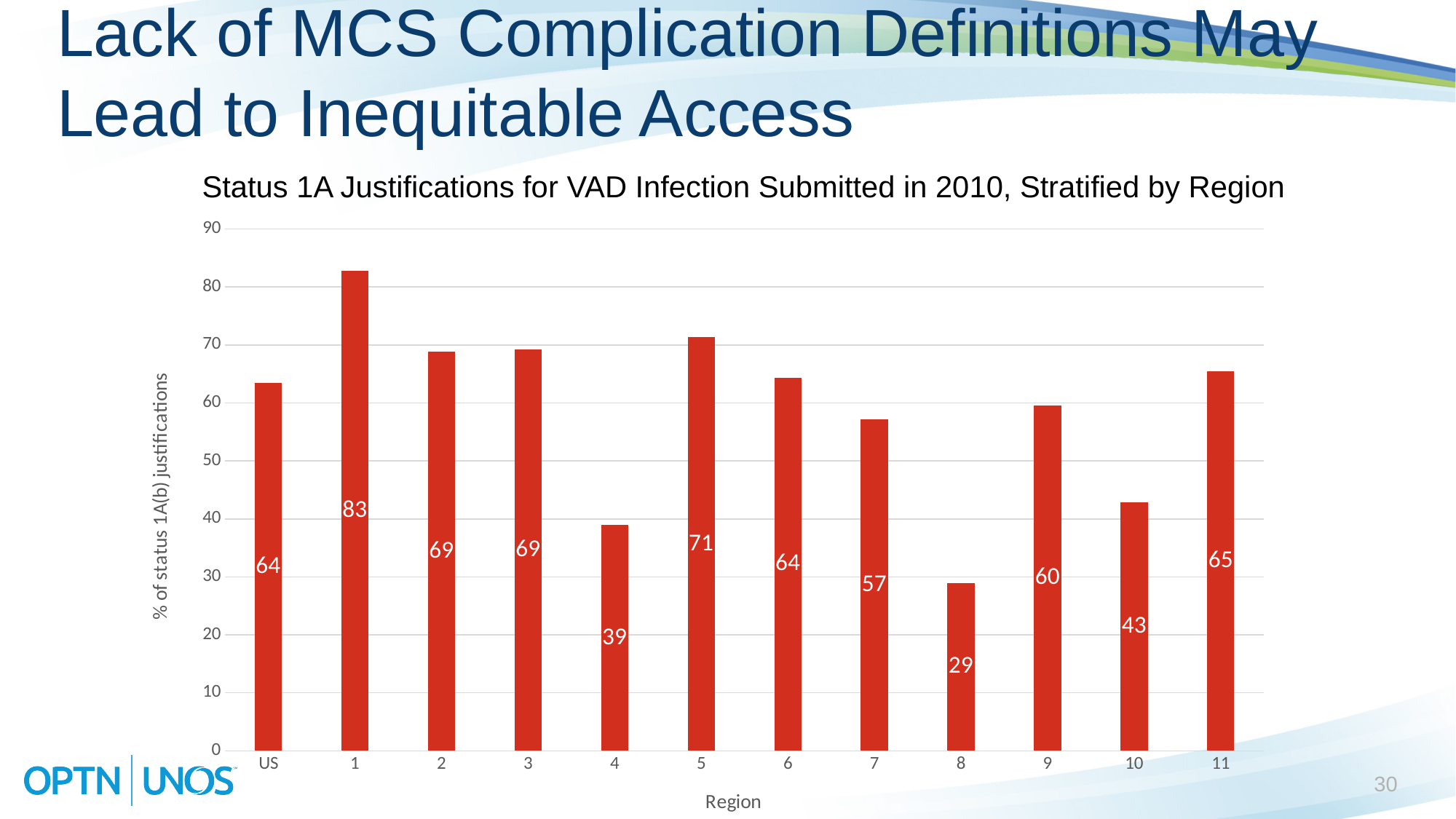
What is the value for the US bar? 64 Is the value for Region 5 greater or less than 70? greater How many bars are shown in the chart? 12 What is the value for Region 1? 83 What kind of chart is shown on the slide? bar chart Which region has the lowest value? 8 What is the difference between the values for Region 1 and Region 8? 54 What is the value for Region 8? 29 Which has a larger value, Region 4 or Region 10? Region 10 What is the label of the x axis? Region Which region has the highest value? 1 What is the title of the chart? Status 1A Justifications for VAD Infection Submitted in 2010, Stratified by Region